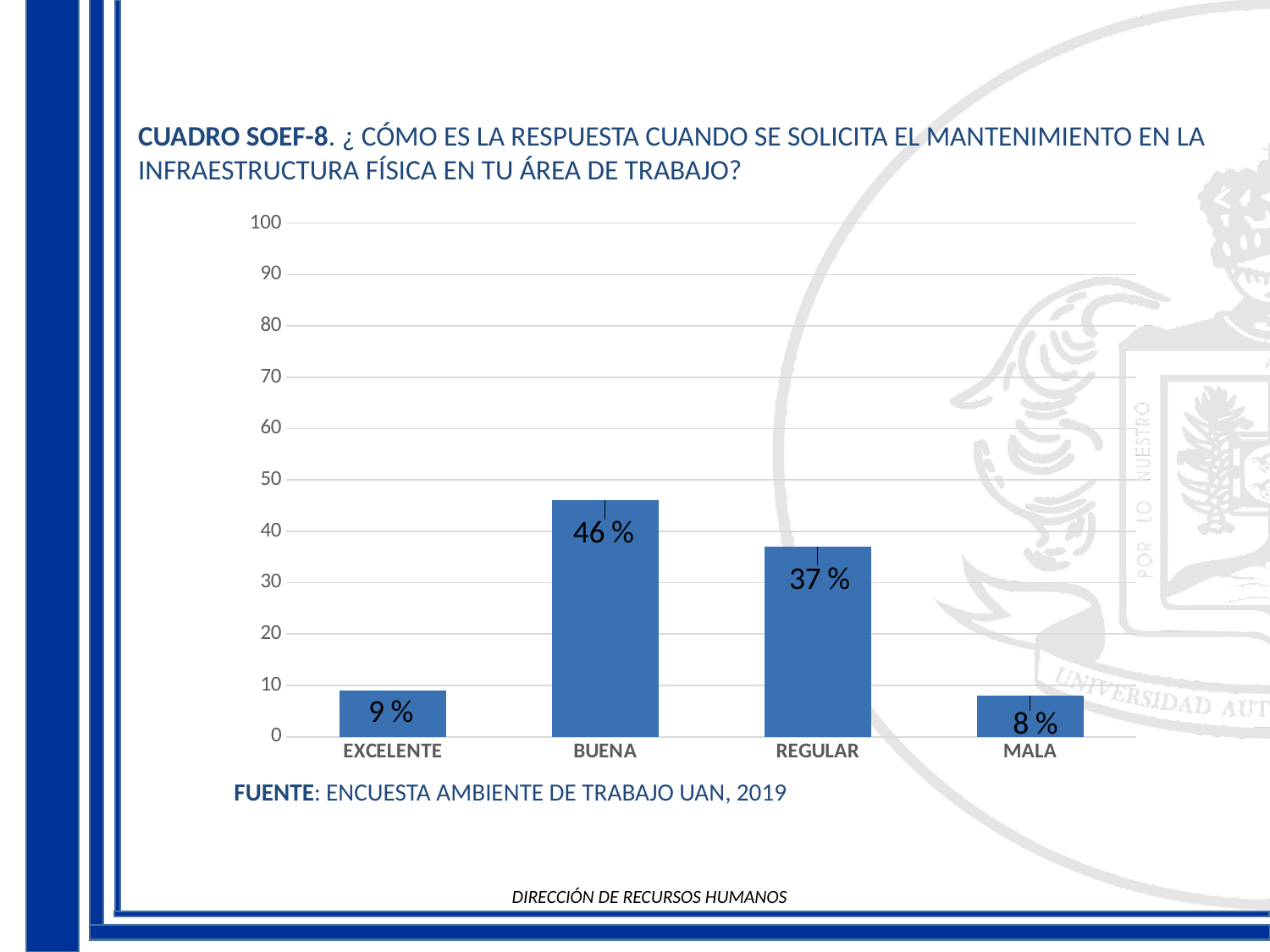
What is the source cited below the chart? ENCUESTA AMBIENTE DE TRABAJO UAN, 2019 What is the value for REGULAR? 37 % What is the value for MALA? 8 % Is the value for BUENA greater or less than 40? greater Which category has the highest value? BUENA How many categories are shown on the x axis? 4 Which is larger, the value for EXCELENTE or the value for REGULAR? REGULAR What is the value for EXCELENTE? 9 % What is the difference between the values for BUENA and REGULAR? 9 % What is the value for BUENA? 46 % What kind of chart is shown on the slide? bar chart What is the highest value shown on the y axis? 100